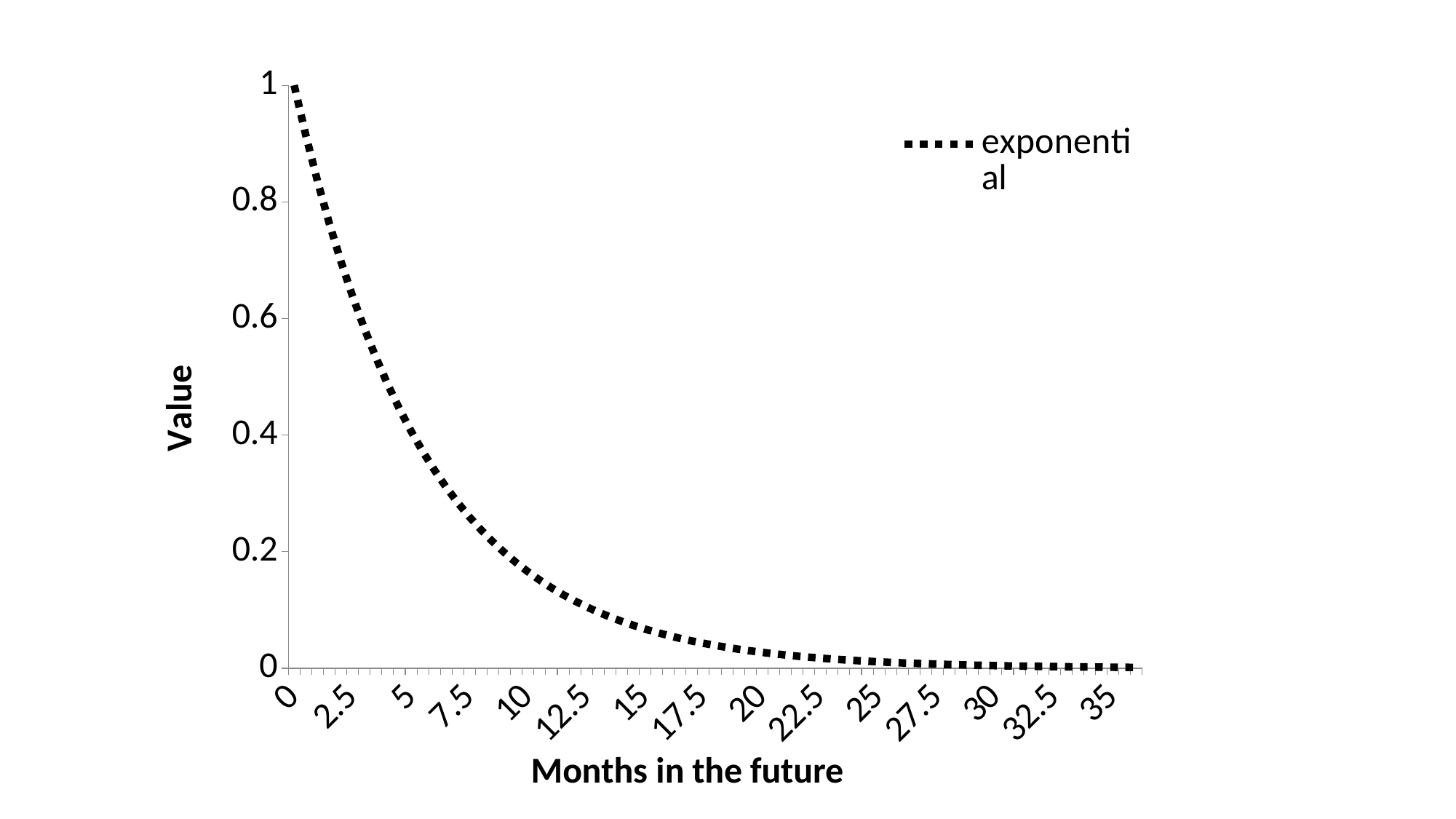
What is the value of the exponential series at 0 months in the future? 1 What kind of chart is shown on the slide? line chart What is the name of the series shown in the legend? exponential Is the value of the exponential series at 15 months greater or less than 0.2? less At which month shown on the x axis is the exponential series at its highest value? 0 Do the values of the exponential series rise or fall as months in the future increase? fall Is the value of the exponential series at 2.5 months greater or less than 0.8? less Which is larger, the value of the exponential series at 5 months or at 25 months? 5 months How many series does the legend list? 1 Is the value of the exponential series at 2.5 months greater or less than 0.6? greater What is the title of the x axis? Months in the future